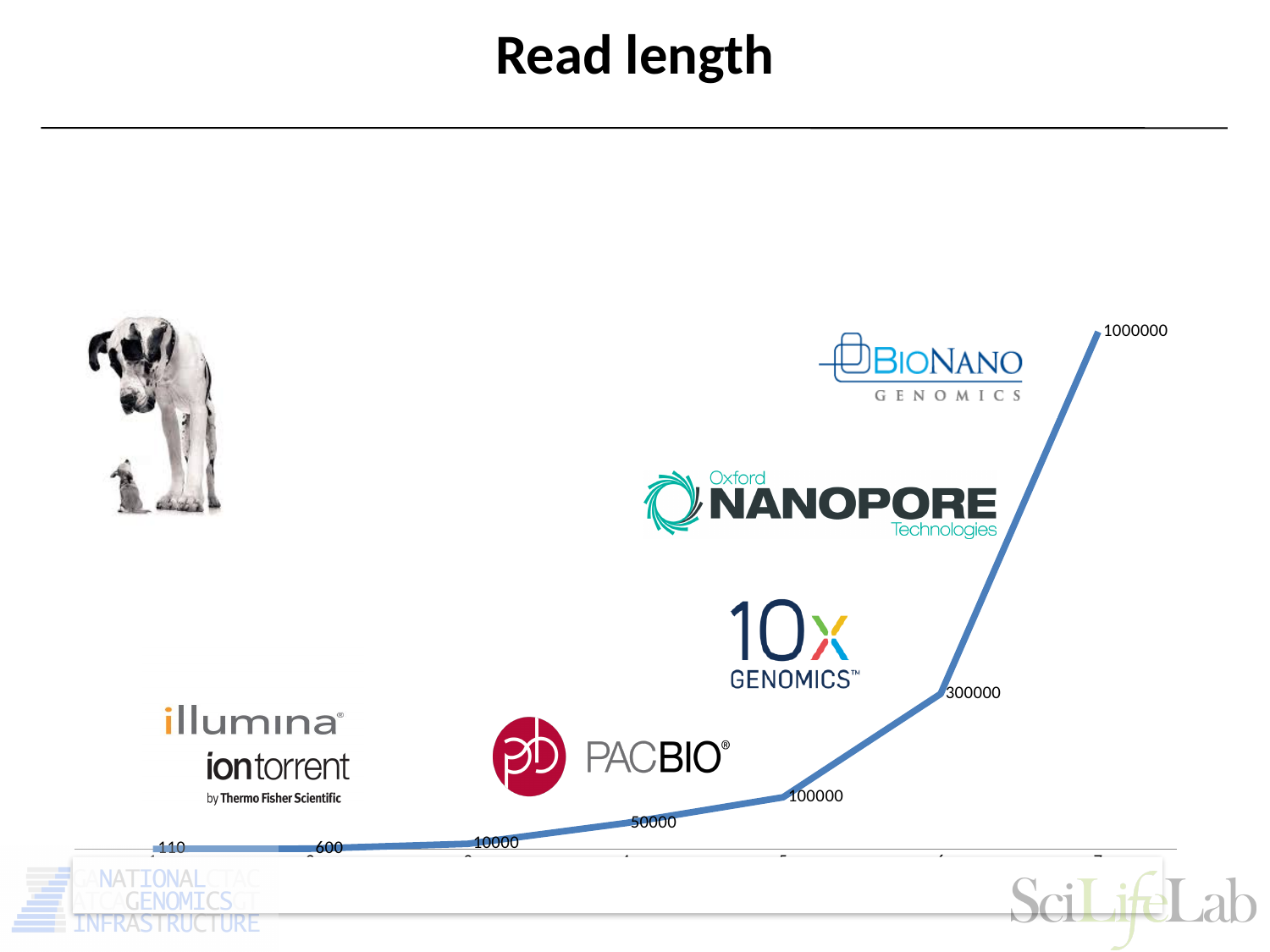
What is the value of the second data point on the line? 600 Do the values rise or fall from left to right along the line? rise What is the value of the first (leftmost) data point on the line? 110 What is the value of the fourth data point on the line? 50000 How many data points are plotted on the line? 7 What is the title of the slide containing the chart? Read length What is the highest value labelled on the line? 1000000 What is the lowest value labelled on the line? 110 What kind of chart is shown on the slide? line chart Which is larger, the third data point (10000) or the fifth data point (100000)? 100000 What is the difference between the last data point (1000000) and the sixth data point (300000)? 700000 What is the value of the last (rightmost) data point on the line? 1000000